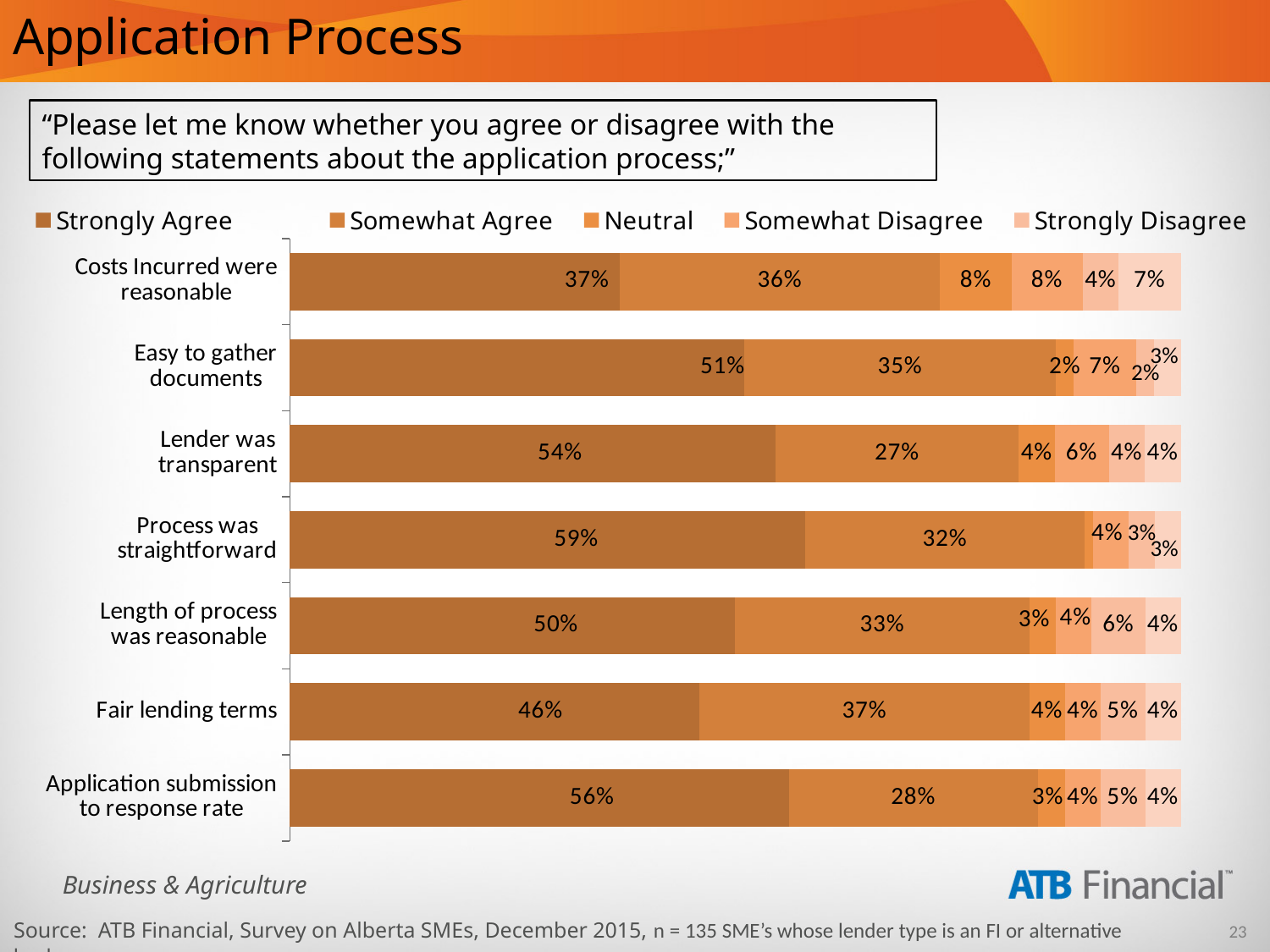
What is the Strongly Agree value for 'Application submission to response rate'? 56% What is the difference in Strongly Agree percentage between 'Process was straightforward' and 'Costs Incurred were reasonable'? 22 percentage points What percentage of respondents strongly agree that the process was straightforward? 59% Which statement has the lowest Strongly Agree percentage? Costs Incurred were reasonable Which has a larger Somewhat Agree value: 'Costs Incurred were reasonable' or 'Lender was transparent'? Costs Incurred were reasonable What type of chart is shown on the slide? Stacked bar chart What is the first entry in the chart's legend? Strongly Agree Which statement has the highest Strongly Agree percentage? Process was straightforward What is the Somewhat Agree value for 'Easy to gather documents'? 35% What is the Somewhat Agree value for 'Fair lending terms'? 37% How many series does the legend list? 5 How many statements (categories) are shown in the chart? 7